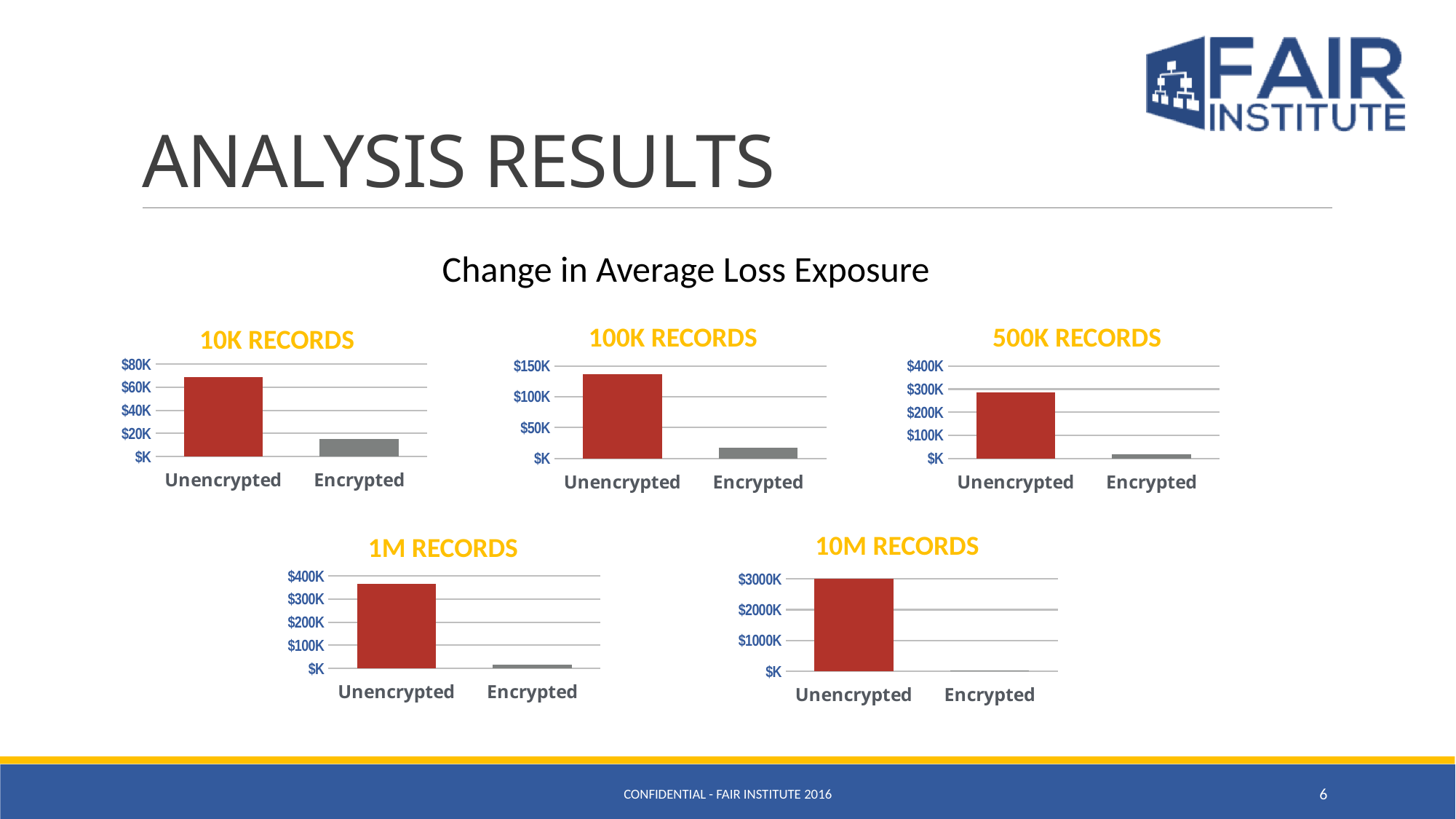
What kind of chart is the 10M RECORDS chart? Bar chart In the 1M RECORDS chart, which category has the lowest value? Encrypted In the 100K RECORDS chart, is the value for Unencrypted greater or less than $100K? greater In the 10M RECORDS chart, is the value for Unencrypted greater or less than $2000K? greater In the 100K RECORDS chart, is the value for Encrypted greater or less than $50K? less In the 500K RECORDS chart, which category has the higher value, Unencrypted or Encrypted? Unencrypted How many categories are shown in the 100K RECORDS chart? 2